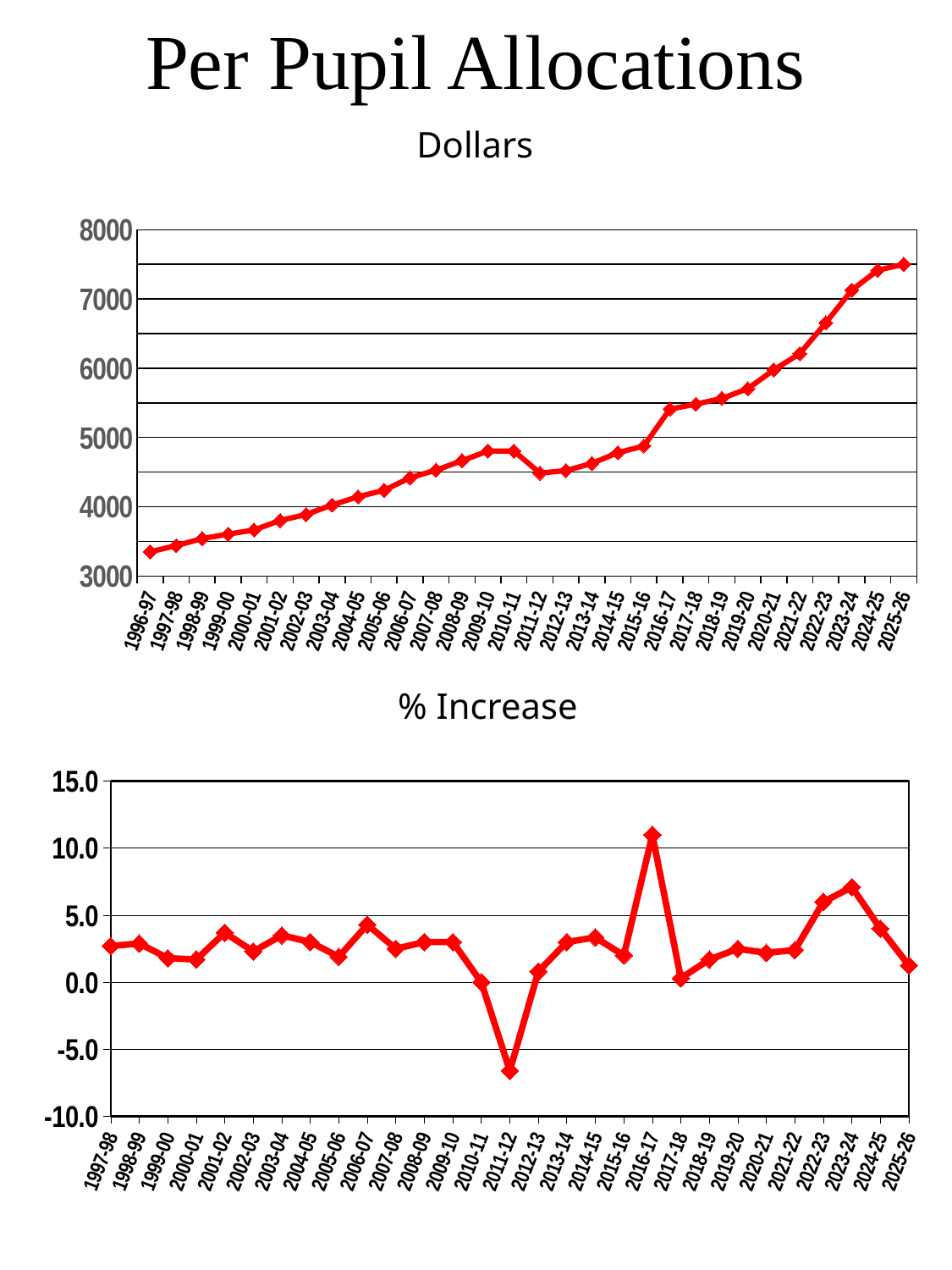
What kind of chart is the "Dollars" chart? line chart On the "Dollars" chart, which year has the highest value? 2025-26 On the "Dollars" chart, is the value for 2025-26 greater or less than 7000? greater What is the title of the slide containing the two charts? Per Pupil Allocations On the "Dollars" chart, do the values generally rise or fall from 1996-97 to 2025-26? rise On the "% Increase" chart, is the value for 2011-12 greater or less than -5.0? less On the "Dollars" chart, is the value for 1996-97 greater or less than 4000? less How many data points are plotted on the "% Increase" chart? 29 On the "% Increase" chart, which year has the highest value? 2016-17 On the "Dollars" chart, which year has the lowest value? 1996-97 On the "% Increase" chart, which year has the lowest value? 2011-12 How many data points are plotted on the "Dollars" chart? 30